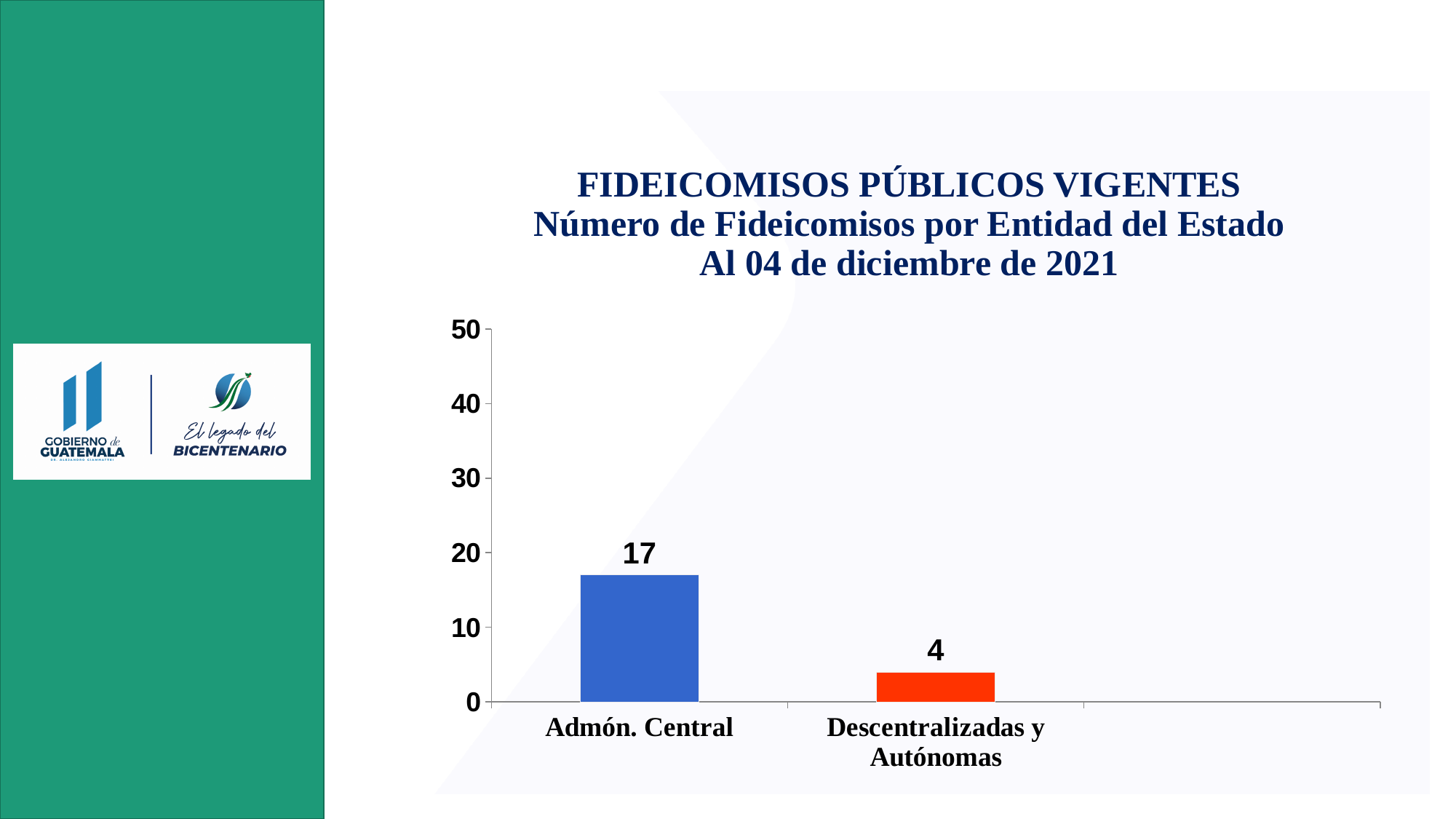
How many categories are shown on the x axis? 2 What is the value for Admón. Central? 17 Is the value for Admón. Central greater or less than 20? less What is the total of the two values shown in the chart? 21 Which is larger, the value for Admón. Central or the value for Descentralizadas y Autónomas? Admón. Central Which category has the highest value? Admón. Central What kind of chart is shown on the slide? bar chart What is the value for Descentralizadas y Autónomas? 4 Which category has the lowest value? Descentralizadas y Autónomas Is the value for Descentralizadas y Autónomas greater or less than 10? less What date does the chart title say the data is as of? 04 de diciembre de 2021 What is the difference between the values for Admón. Central and Descentralizadas y Autónomas? 13